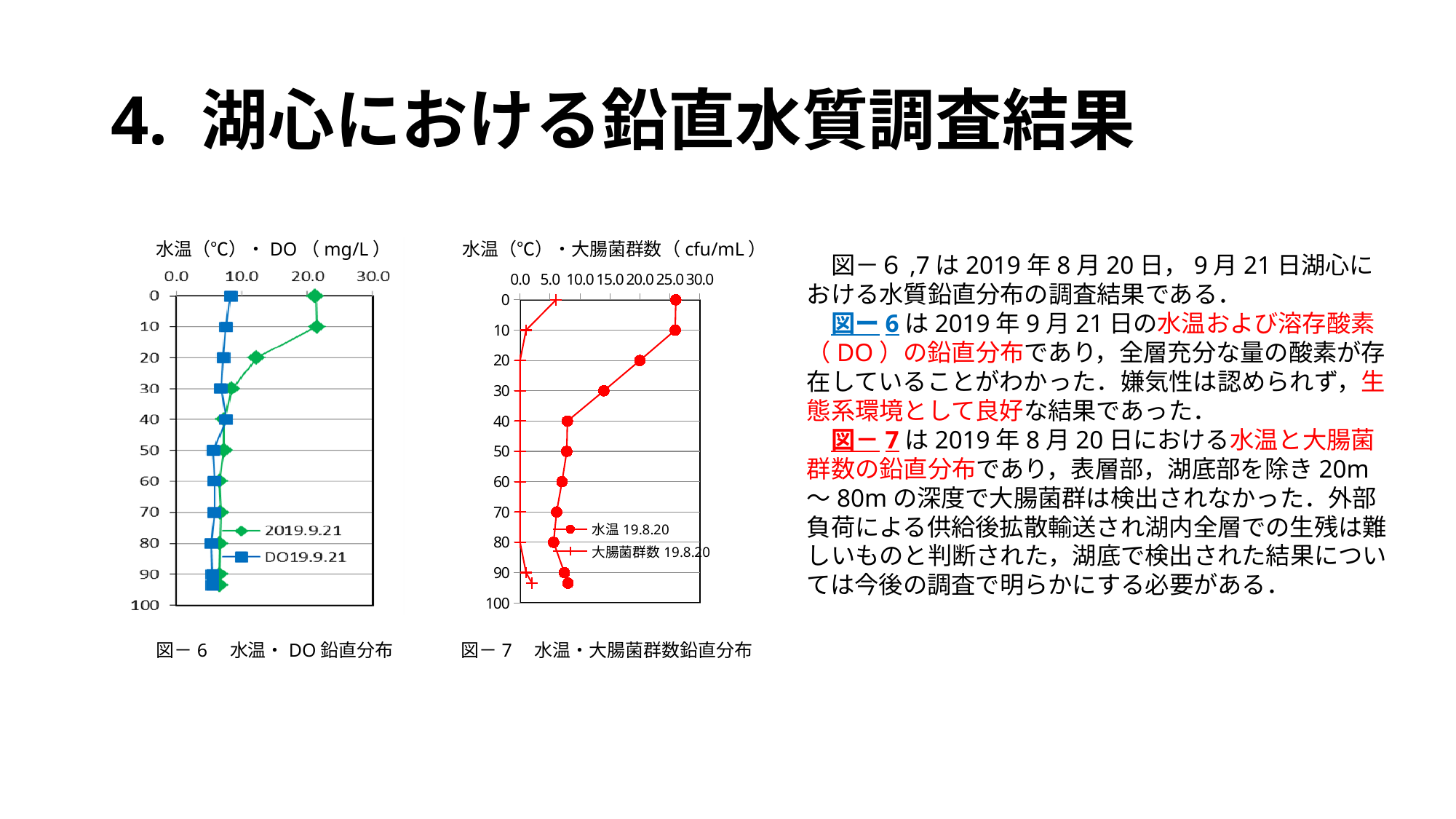
In 図－6 (水温・DO鉛直分布), is the DO19.9.21 value at depth 0 greater or less than 10.0? less In 図－7 (水温・大腸菌群数鉛直分布), is the 水温 19.8.20 value at depth 0 greater or less than 20.0? greater What are the two legend entries in 図－6 (水温・DO鉛直分布)? 2019.9.21 and DO19.9.21 How many series does the legend of 図－7 (水温・大腸菌群数鉛直分布) list? 2 In 図－6 (水温・DO鉛直分布), does the 2019.9.21 water temperature rise or fall as depth increases from 10 to 40? fall In 図－7 (水温・大腸菌群数鉛直分布), at which depth is the 大腸菌群数 19.8.20 value highest? 0 What kind of chart is 図－6 (水温・DO鉛直分布)? line chart In 図－7 (水温・大腸菌群数鉛直分布), is the 水温 19.8.20 value at depth 40 greater or less than 15.0? less In 図－6 (水温・DO鉛直分布), at depth 0, which series has the larger value: 2019.9.21 or DO19.9.21? 2019.9.21 How many series does the legend of 図－6 (水温・DO鉛直分布) list? 2